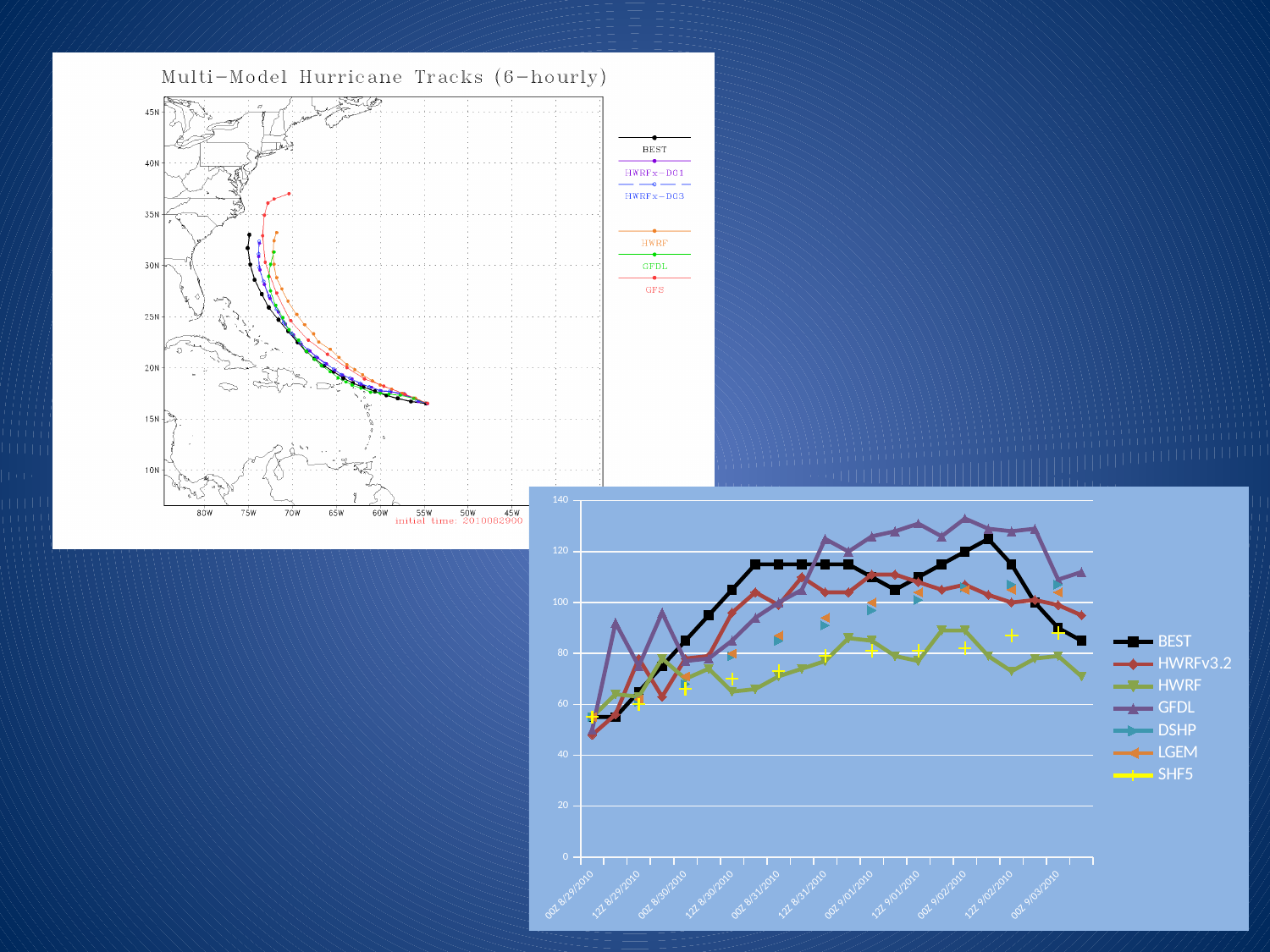
How many date labels are shown along the x axis of the bottom-right line chart? 11 In the bottom-right line chart, does the BEST series end higher or lower than it starts? higher In the bottom-right line chart, is the highest value of the SHF5 series greater or less than 100? less In the bottom-right line chart, is the highest value of the GFDL series greater or less than 120? greater What kind of chart is the chart in the bottom right of the slide? line chart In the bottom-right line chart, which series reaches the highest value on the chart? GFDL In the bottom-right line chart, is the first value of the HWRFv3.2 series greater or less than 60? less In the bottom-right line chart, which series is drawn with yellow plus-sign markers? SHF5 What is the title of the map chart in the top left of the slide? Multi-Model Hurricane Tracks (6-hourly) How many series does the legend of the bottom-right line chart list? 7 How many entries does the legend of the top-left hurricane tracks map list? 6